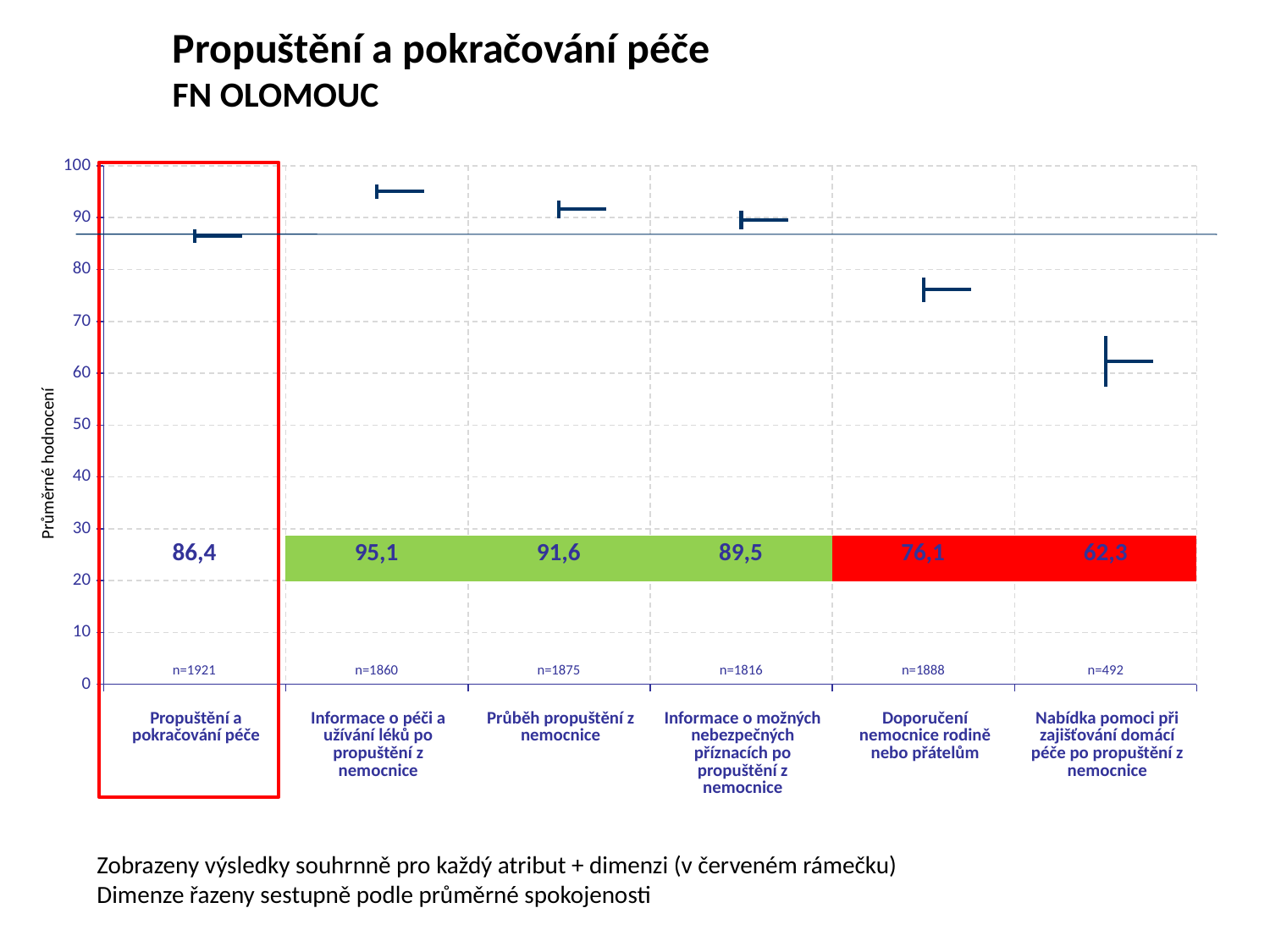
What is the average rating for 'Doporučení nemocnice rodině nebo přátelům'? 76,1 What is the average rating for 'Informace o péči a užívání léků po propuštění z nemocnice'? 95,1 Which attribute has the lowest average rating? Nabídka pomoci při zajišťování domácí péče po propuštění z nemocnice How many categories are shown on the x axis of the chart? 6 What is the average rating for 'Nabídka pomoci při zajišťování domácí péče po propuštění z nemocnice'? 62,3 Which has a higher average rating: 'Doporučení nemocnice rodině nebo přátelům' or 'Průběh propuštění z nemocnice'? Průběh propuštění z nemocnice What is the average rating shown for the overall dimension 'Propuštění a pokračování péče' in the red frame? 86,4 What is the difference between the average ratings for 'Průběh propuštění z nemocnice' and 'Informace o možných nebezpečných příznacích po propuštění z nemocnice'? 2,1 Which attribute has the highest average rating? Informace o péči a užívání léků po propuštění z nemocnice Is the average rating for 'Nabídka pomoci při zajišťování domácí péče po propuštění z nemocnice' greater or less than 70? less What is the label of the vertical axis of the chart? Průměrné hodnocení What is the number of respondents (n) shown for 'Nabídka pomoci při zajišťování domácí péče po propuštění z nemocnice'? n=492